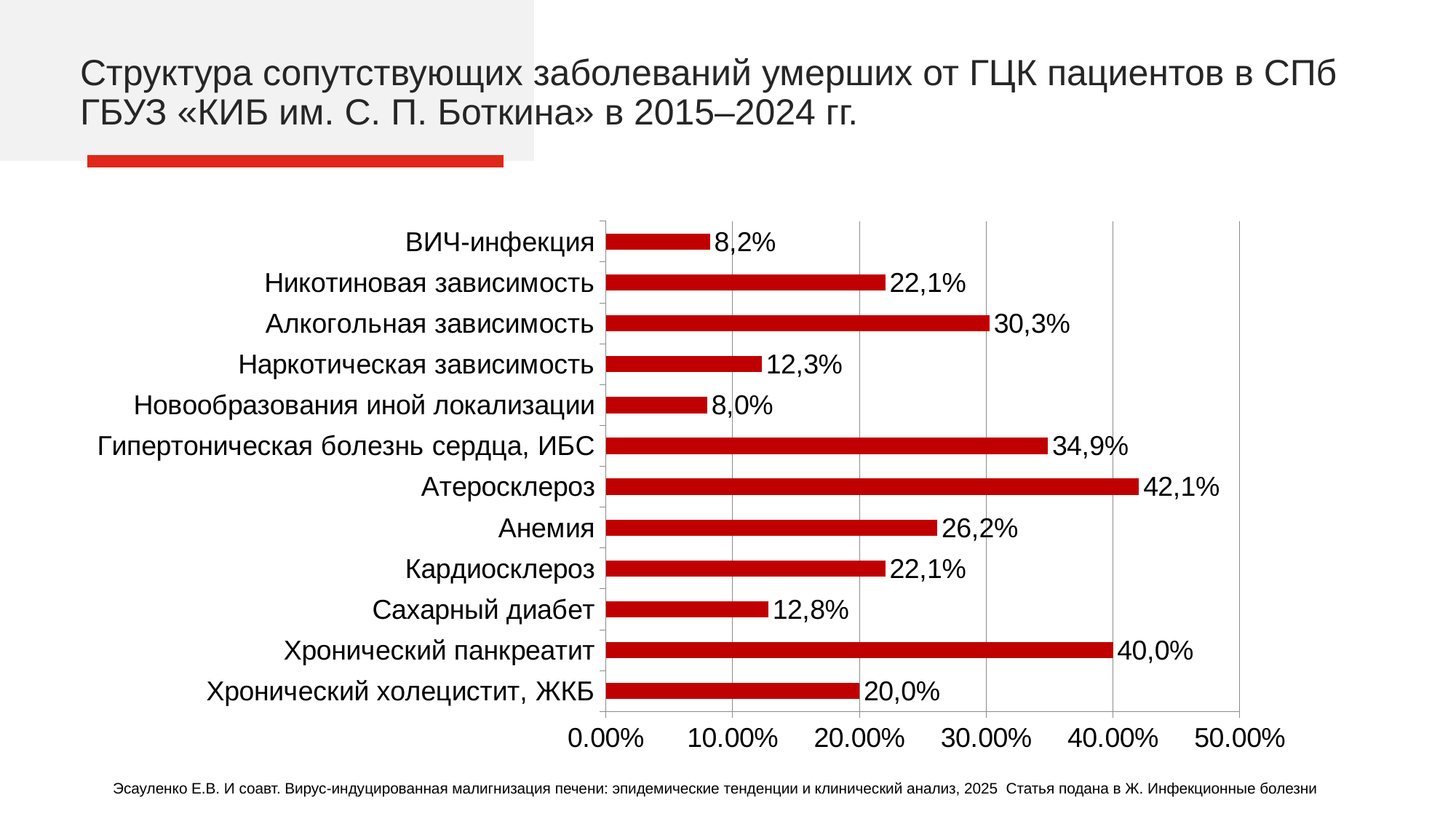
What is the value for Атеросклероз? 42,1% Which is larger, the value for Анемия or the value for Кардиосклероз? Анемия Which category has the highest value? Атеросклероз What is the difference between the values for Атеросклероз and Хронический панкреатит? 2,1% What kind of chart is shown on the slide? bar chart What is the value for Наркотическая зависимость? 12,3% Which category has the lowest value? Новообразования иной локализации Is the value for Гипертоническая болезнь сердца, ИБС greater or less than 30.00%? greater What is the highest value shown on the x axis? 50.00% What is the value for Хронический холецистит, ЖКБ? 20,0% What is the difference between the values for Алкогольная зависимость and Никотиновая зависимость? 8,2% How many categories are shown in the chart? 12